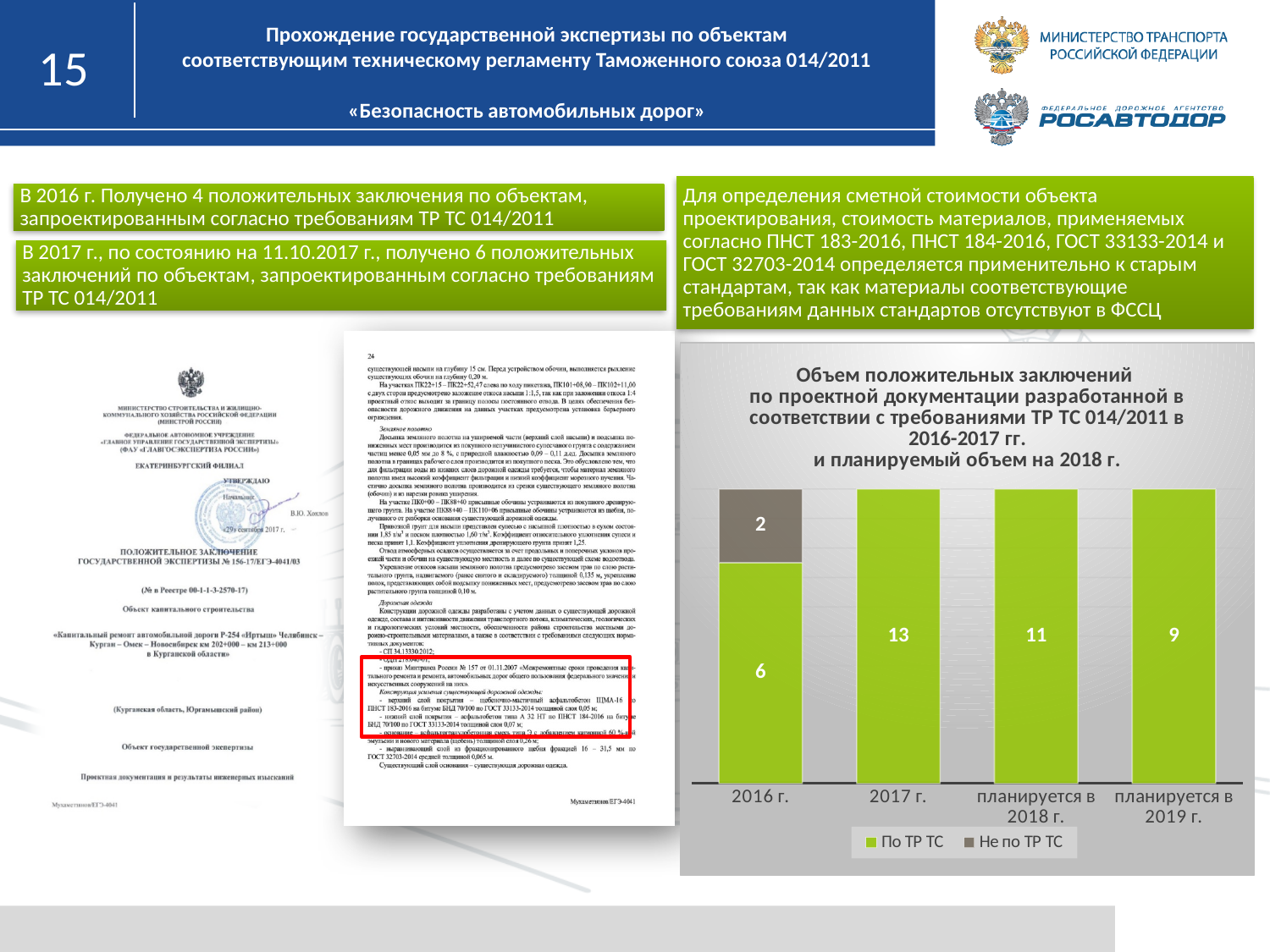
What is the total of the stacked bar for 2016 г.? 8 Which category has the lowest value for the "По ТР ТС" series? 2016 г. What is the difference between the "По ТР ТС" values for 2017 г. and 2016 г.? 7 How many categories are shown on the x axis of the chart? 4 Which category has the highest value for the "По ТР ТС" series? 2017 г. What is the value of the "Не по ТР ТС" series for 2016 г.? 2 What is the value of the "По ТР ТС" series for "планируется в 2019 г."? 9 Which colour represents the "Не по ТР ТС" series in the chart? Grey Which is larger: the "По ТР ТС" value for "планируется в 2018 г." or for "планируется в 2019 г."? планируется в 2018 г. How many series does the chart legend list? 2 What kind of chart is shown on the slide? Stacked bar chart What is the value of the "По ТР ТС" series for 2017 г.? 13